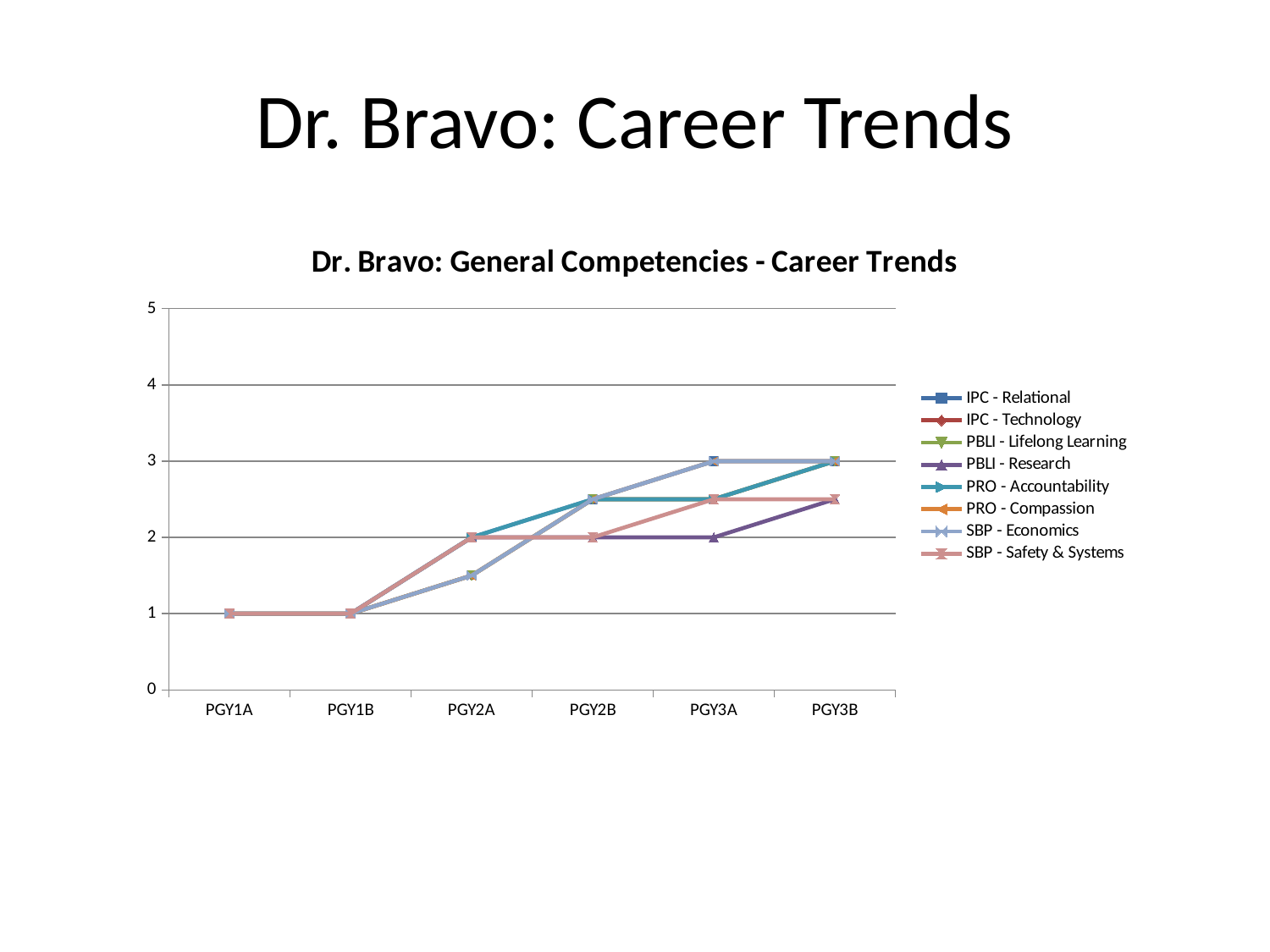
How many series does the legend list? 8 How many categories are shown on the x axis? 6 What is the value for PRO - Accountability at PGY3B? 3 What is the title of the chart? Dr. Bravo: General Competencies - Career Trends What is the value for PBLI - Research at PGY3A? 2 What is the value for IPC - Relational at PGY1A? 1 Which series is listed first in the legend? IPC - Relational What kind of chart is shown on the slide? line chart Is the value for PBLI - Research at PGY3A greater or less than 3? less Is the value for SBP - Safety & Systems at PGY3B greater or less than 2? greater Which is larger at PGY3B: PRO - Accountability or PBLI - Research? PRO - Accountability Do the values generally rise or fall from PGY1A to PGY3B? rise